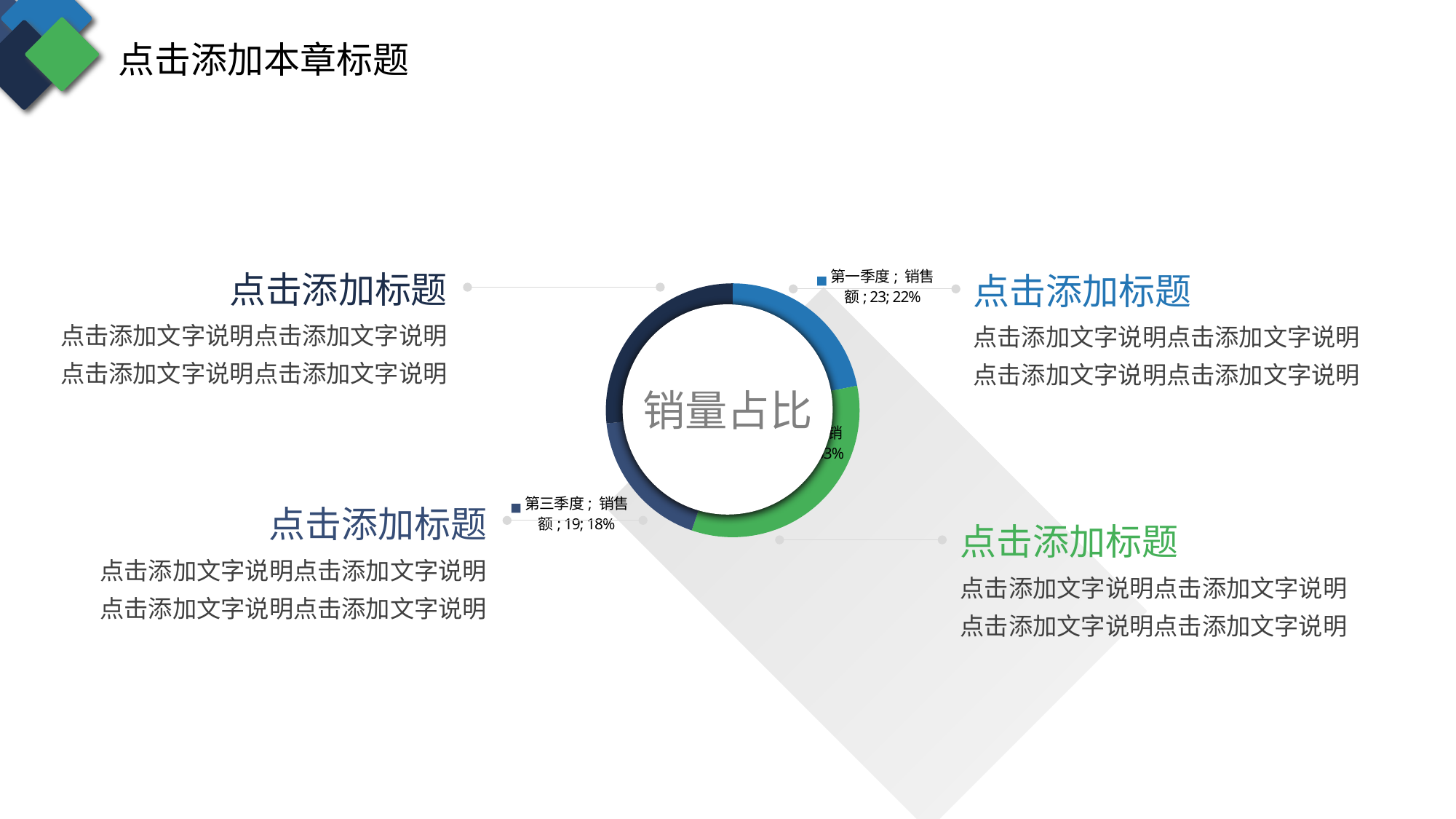
Which has the larger 销售额 value, 第一季度 or 第三季度? 第一季度 What percentage share does 第三季度 have in the chart? 18% What percentage share does 第一季度 have in the chart? 22% What is the difference between the 销售额 values of 第一季度 and 第三季度? 4 What colour is the 第一季度 segment of the chart? blue What is the title shown in the centre of the chart? 销量占比 What is the 销售额 value for 第一季度? 23 By how many percentage points does the share of 第一季度 exceed that of 第三季度? 4% What is the 销售额 value for 第三季度? 19 What type of chart is shown on the slide? doughnut chart